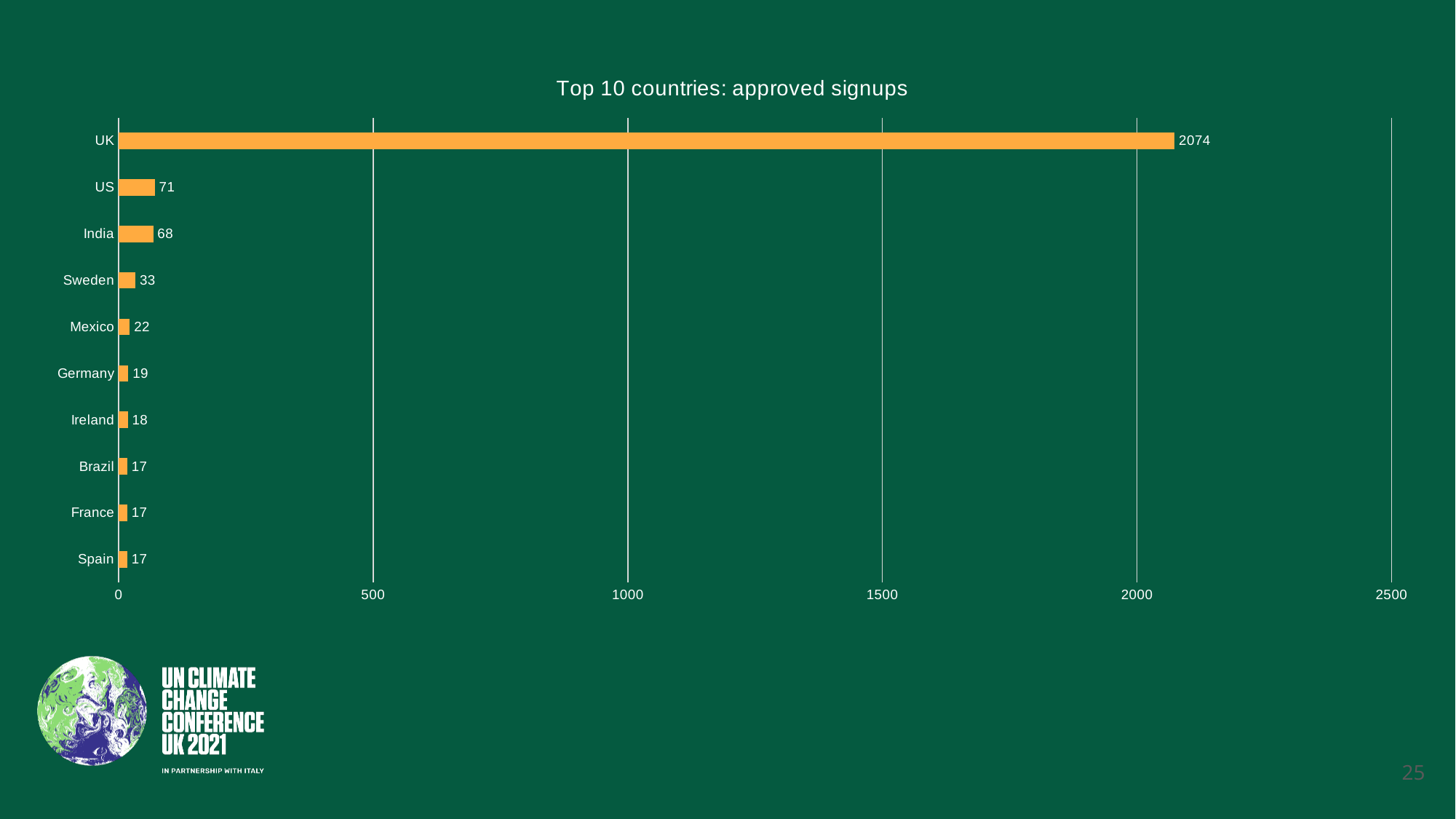
How many countries are shown in the chart? 10 Which country has the highest number of approved signups? UK What is the number of approved signups for the UK? 2074 What kind of chart is shown on the slide? Bar chart What is the title of the chart? Top 10 countries: approved signups What is the number of approved signups for Sweden? 33 What is the number of approved signups for Mexico? 22 What is the difference in approved signups between the US and India? 3 What is the difference in approved signups between the UK and the US? 2003 Is the value for the UK greater or less than 2000? greater What is the number of approved signups for India? 68 Which has more approved signups, Germany or Ireland? Germany